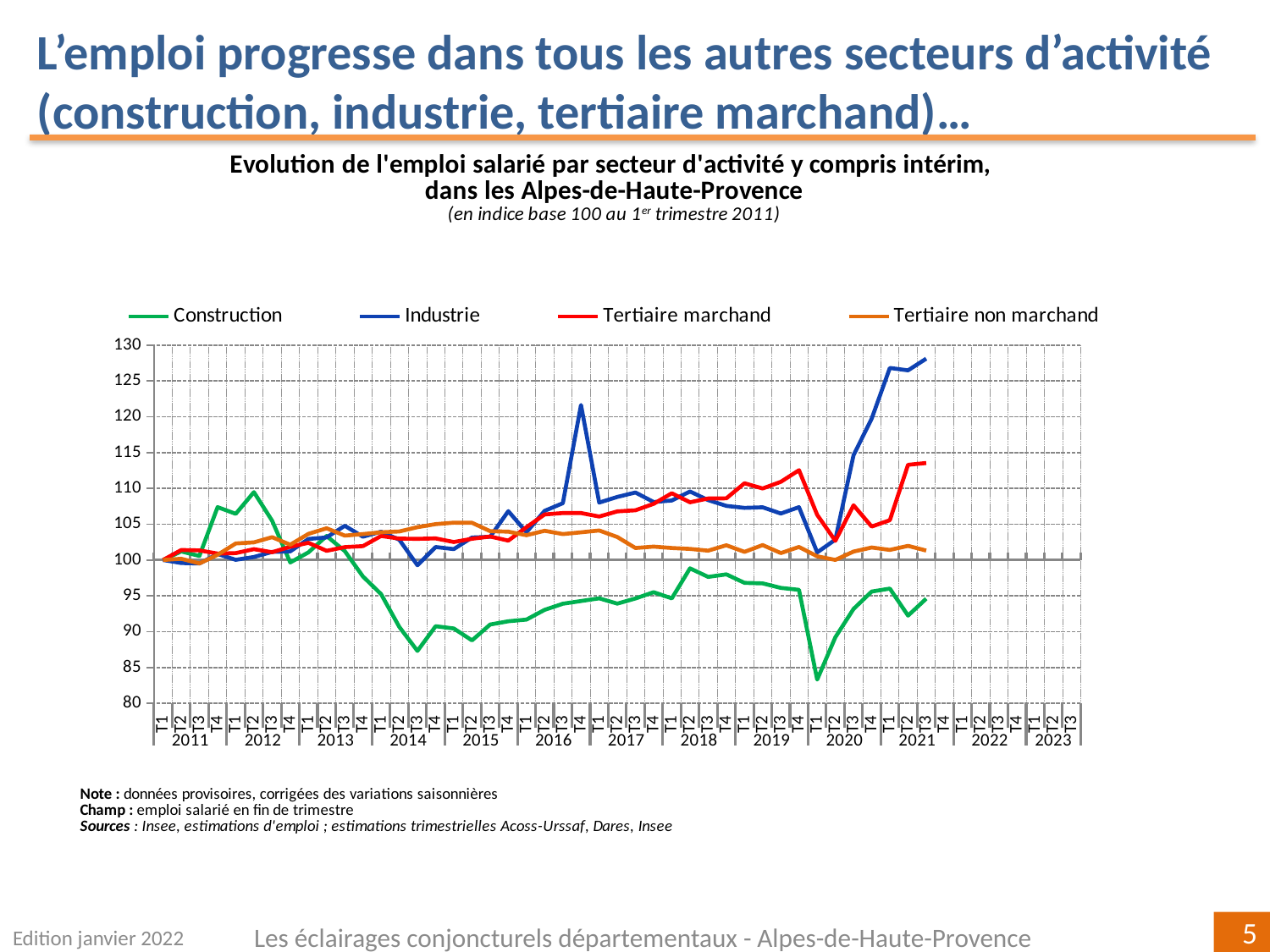
What is the base of the index used in the chart, according to the subtitle? base 100 au 1er trimestre 2011 Does the Industrie series rise or fall between T1 2020 and T1 2021? rise Which series has the lowest value at T3 2021? Construction Is the value for Tertiaire marchand at T3 2021 greater or less than 110? greater Is the value for Construction at T1 2020 greater or less than 85? less Which series is drawn in green? Construction Is the value for Construction at T3 2014 greater or less than 90? less Which series has the highest value at T3 2021? Industrie What kind of chart is shown on the slide? line chart How many series does the legend list? 4